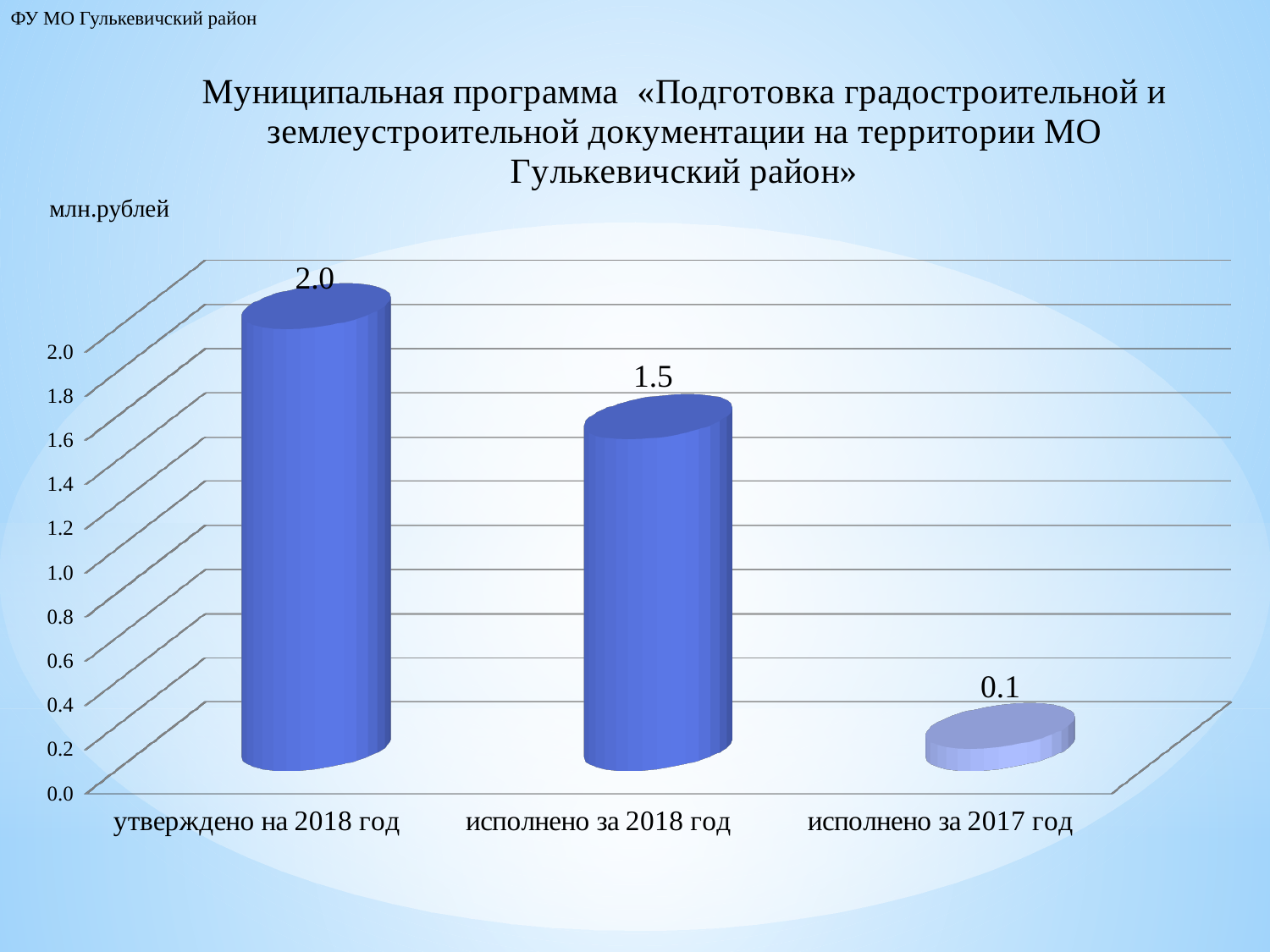
What is the value for «утверждено на 2018 год»? 2.0 Which category has the highest value? утверждено на 2018 год What is the difference between the value for «исполнено за 2018 год» and the value for «исполнено за 2017 год»? 1.4 Which is larger: the value for «исполнено за 2018 год» or the value for «исполнено за 2017 год»? исполнено за 2018 год What is the difference between the value for «утверждено на 2018 год» and the value for «исполнено за 2018 год»? 0.5 What is the value for «исполнено за 2018 год»? 1.5 What kind of chart is shown on the slide? bar chart Is the value for «исполнено за 2018 год» greater or less than 1.0? greater What unit is indicated for the values on the chart? млн.рублей What is the value for «исполнено за 2017 год»? 0.1 How many categories are shown on the chart? 3 Which category has the lowest value? исполнено за 2017 год